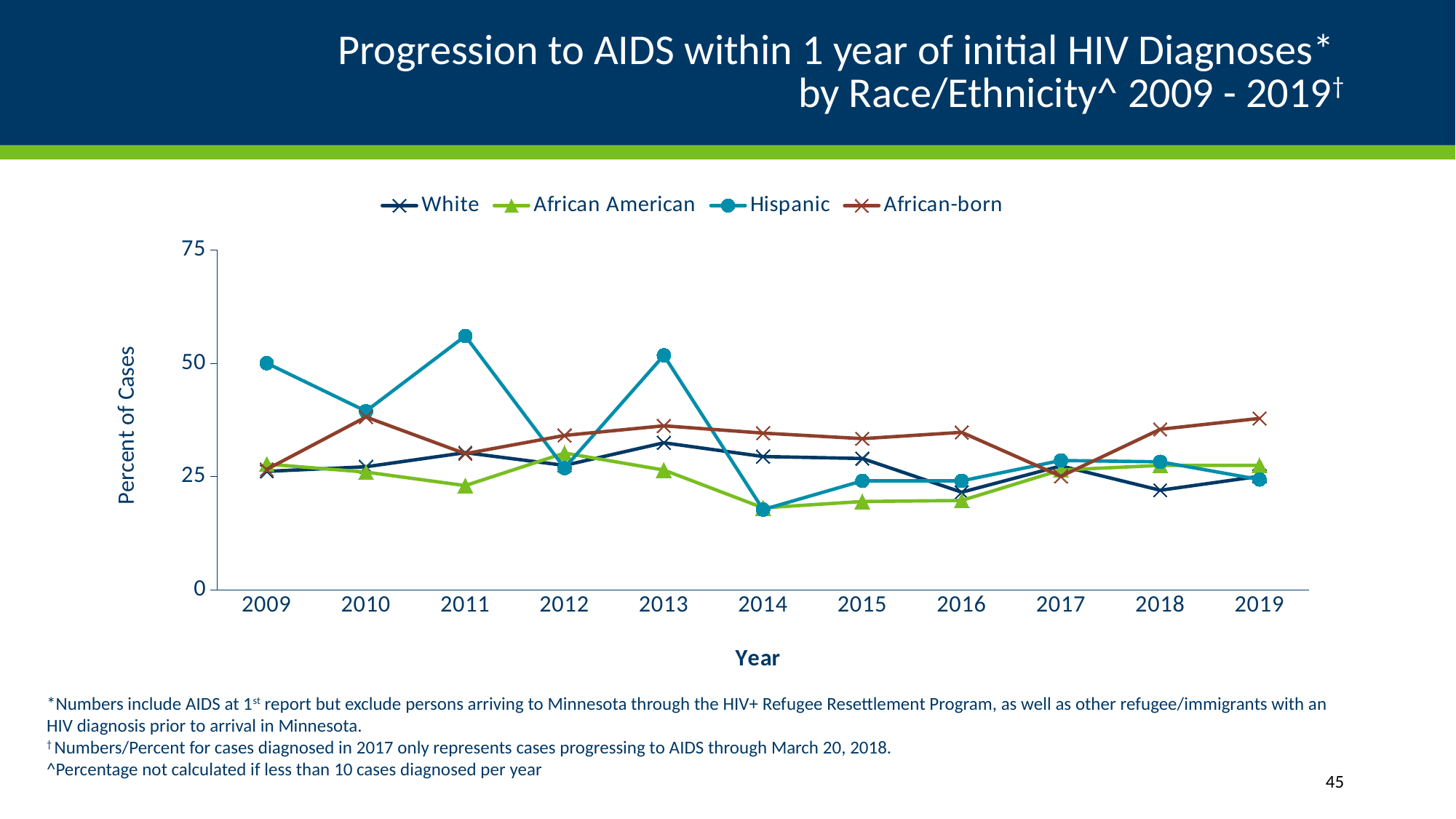
What kind of chart is shown on the slide? line chart How many series does the legend list? 4 In 2013, which is larger: the value for Hispanic or the value for African American? Hispanic Does the Hispanic line rise or fall from 2013 to 2014? fall What is the label on the y axis? Percent of Cases How many years are shown on the x axis? 11 Which series has the lowest value in 2018? White What is the label on the x axis? Year Is the value for Hispanic in 2011 greater or less than 50? greater Is the value for African-born in 2019 greater or less than 25? greater Which series has the highest value in 2011? Hispanic Is the value for African American in 2014 greater or less than 25? less